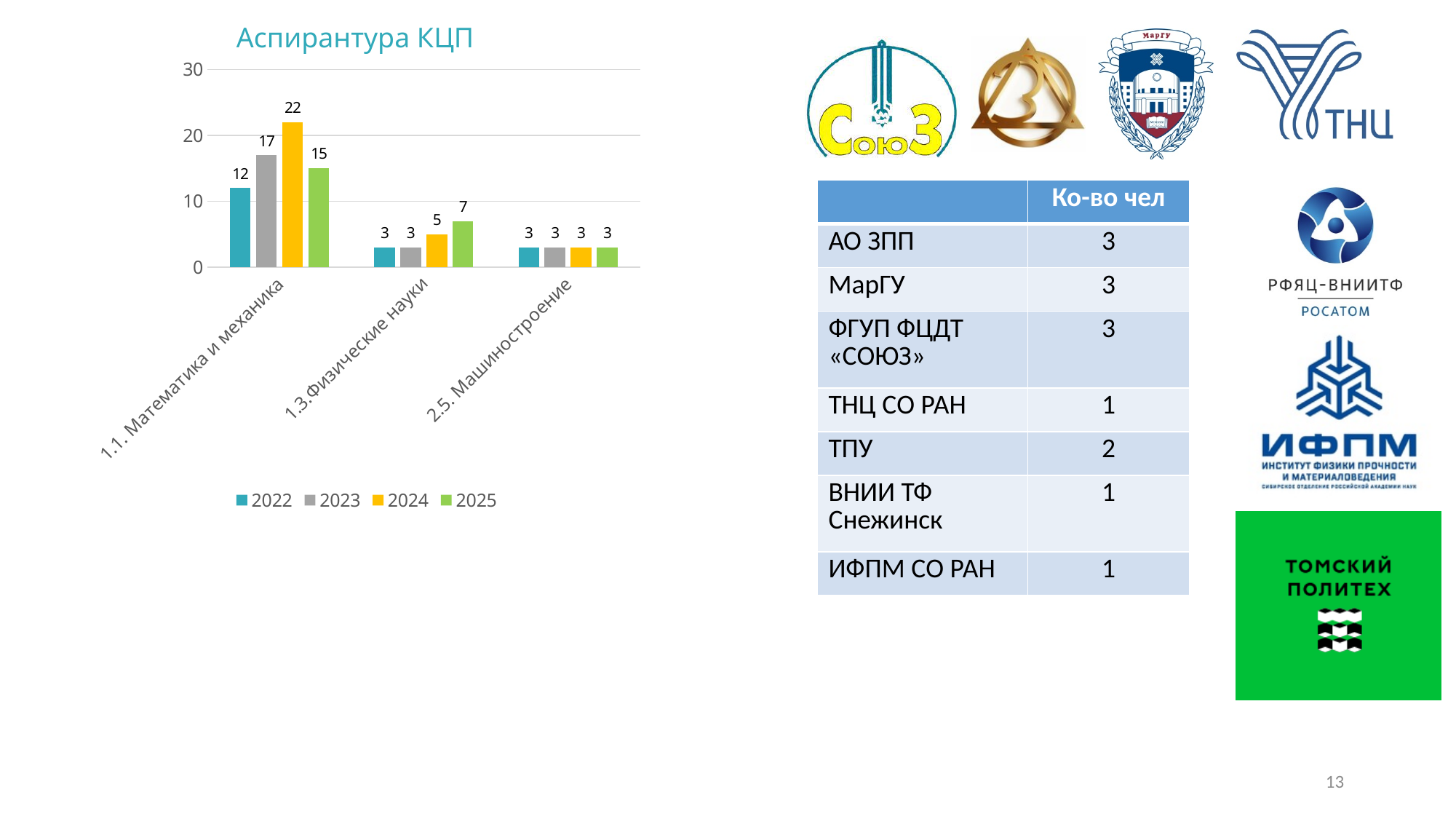
What is the title of the chart? Аспирантура КЦП What is the value for 2024 in the category 1.1. Математика и механика? 22 Which is larger in the category 1.3. Физические науки: the value for 2024 or the value for 2025? 2025 How many series does the legend list? 4 What is the value for 2025 in the category 1.3. Физические науки? 7 What kind of chart is shown on the slide? bar chart Which year has the highest value in the category 1.1. Математика и механика? 2024 Which year has the lowest value in the category 1.1. Математика и механика? 2022 What is the value for 2022 in the category 2.5. Машиностроение? 3 How many categories are shown on the x axis of the chart? 3 Is the value for 2023 in the category 1.1. Математика и механика greater or less than 20? less What is the difference between the 2024 and 2022 values in the category 1.1. Математика и механика? 10